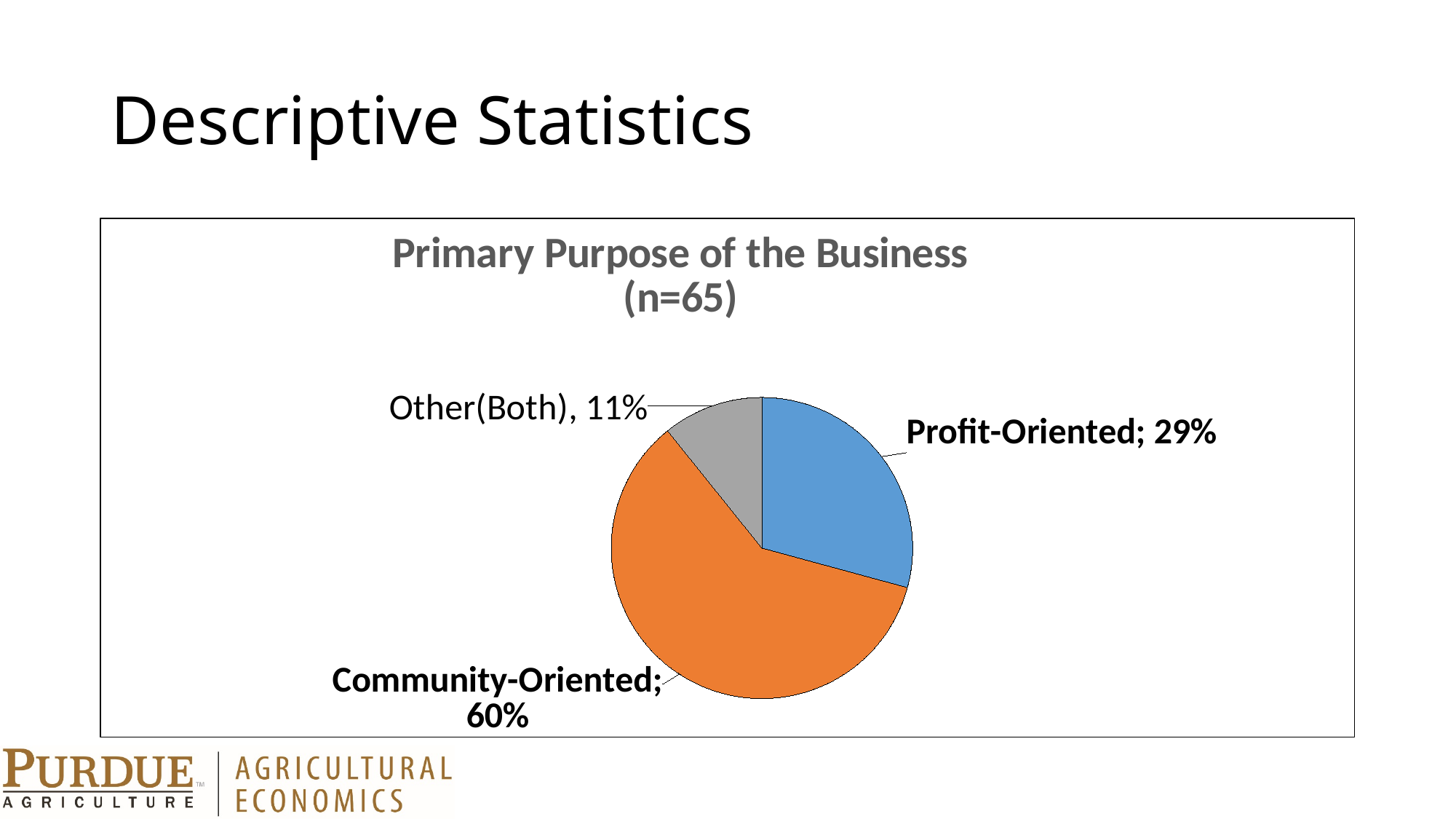
What is the difference in percentage points between Profit-Oriented and Other(Both)? 18 Which category has the smallest slice of the pie? Other(Both) Which category has the largest slice of the pie? Community-Oriented How many slices does the pie chart have? 3 What is the difference in percentage points between Community-Oriented and Profit-Oriented? 31 Which is larger, the Profit-Oriented slice or the Other(Both) slice? Profit-Oriented What share of the pie is Other(Both)? 11% What colour is the Community-Oriented slice? Orange What kind of chart is shown on the slide? Pie chart What is the title of the chart? Primary Purpose of the Business (n=65) What share of the pie is Profit-Oriented? 29% What share of the pie is Community-Oriented? 60%